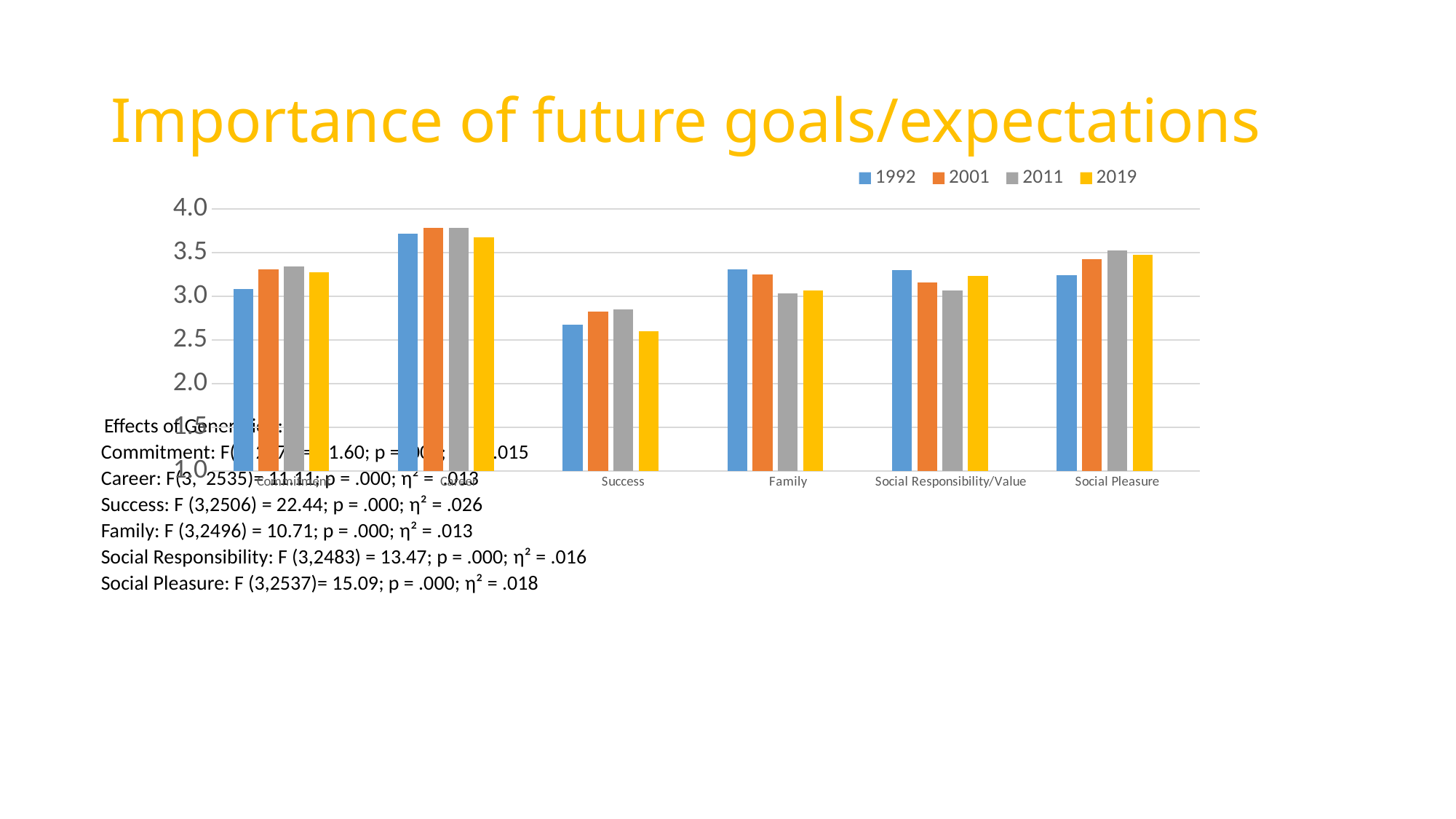
Is the value for Family in 2011 greater or less than 3.5? less For Social Pleasure, which year has the lowest value? 1992 Is the value for Success in 2019 greater or less than 3.0? less Which category has the highest values across all years? Career How many categories are shown along the x axis? 6 Which category has the lowest values across all years? Success What kind of chart is shown on the slide? bar chart How many series does the legend list? 4 Which years are listed in the legend? 1992, 2001, 2011, 2019 Is the value for Career in 2001 greater or less than 3.5? greater What is the title of the slide containing the chart? Importance of future goals/expectations For Family, which is larger: the 1992 value or the 2011 value? 1992